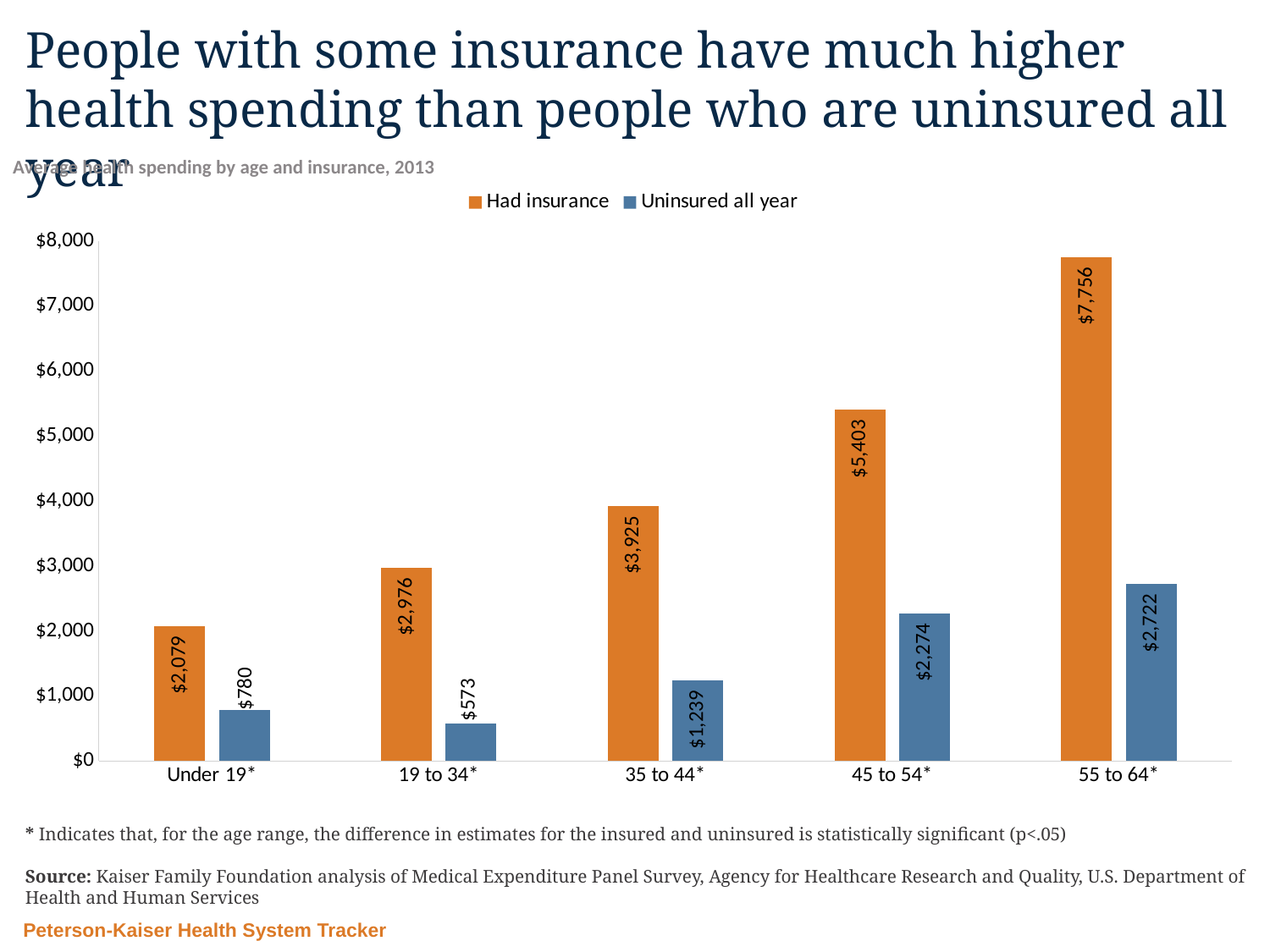
What is the difference between spending for insured and uninsured people in the 45 to 54 age group? $3,129 What is the average health spending for people who had insurance in the 55 to 64 age group? $7,756 Which age group has the lowest average health spending among people uninsured all year? 19 to 34 Which colour represents the 'Uninsured all year' series? Blue What is the average health spending for people who had insurance in the 35 to 44 age group? $3,925 What is the average health spending for people uninsured all year in the 19 to 34 age group? $573 Do the values for people who had insurance rise or fall as age increases along the x axis? Rise Which is larger: spending for uninsured people aged 55 to 64 or spending for insured people aged Under 19? Uninsured all year, 55 to 64 Which age group has the highest average health spending among people who had insurance? 55 to 64 What kind of chart is shown on the slide? Bar chart How many series does the legend list? 2 How many age groups are shown on the x axis? 5